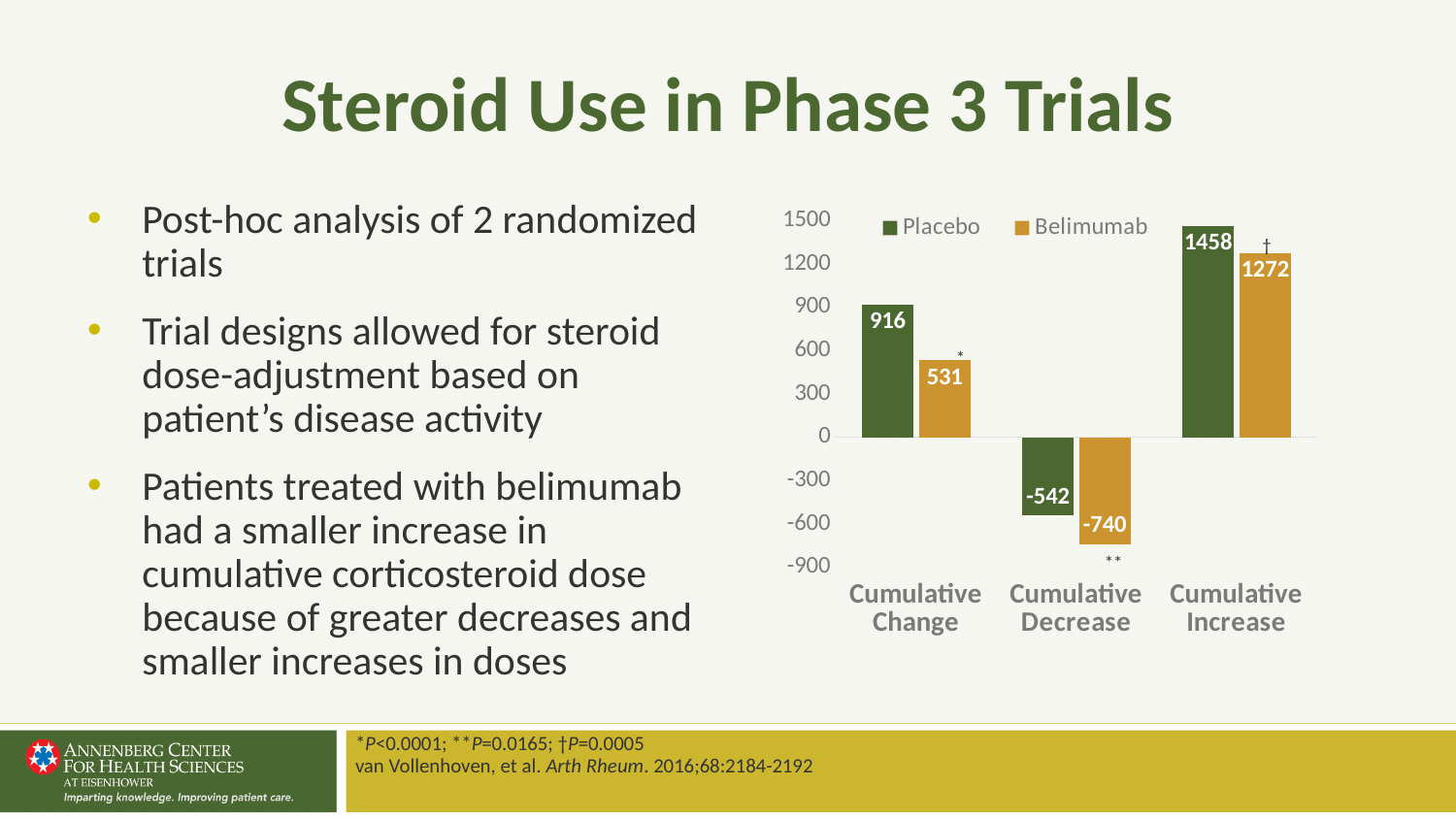
What is the Belimumab value for Cumulative Increase? 1272 What is the Belimumab value for Cumulative Decrease? -740 For Cumulative Change, which series has the larger value, Placebo or Belimumab? Placebo How many series does the legend list? 2 What kind of chart is shown on the slide? Bar chart What is the Placebo value for Cumulative Change? 916 How many categories are shown on the x axis? 3 What is the difference between the Placebo and Belimumab values for Cumulative Change? 385 What is the Placebo value for Cumulative Decrease? -542 What is the difference between the Placebo and Belimumab values for Cumulative Increase? 186 Which category has the highest Placebo value? Cumulative Increase Which category has the lowest Belimumab value? Cumulative Decrease